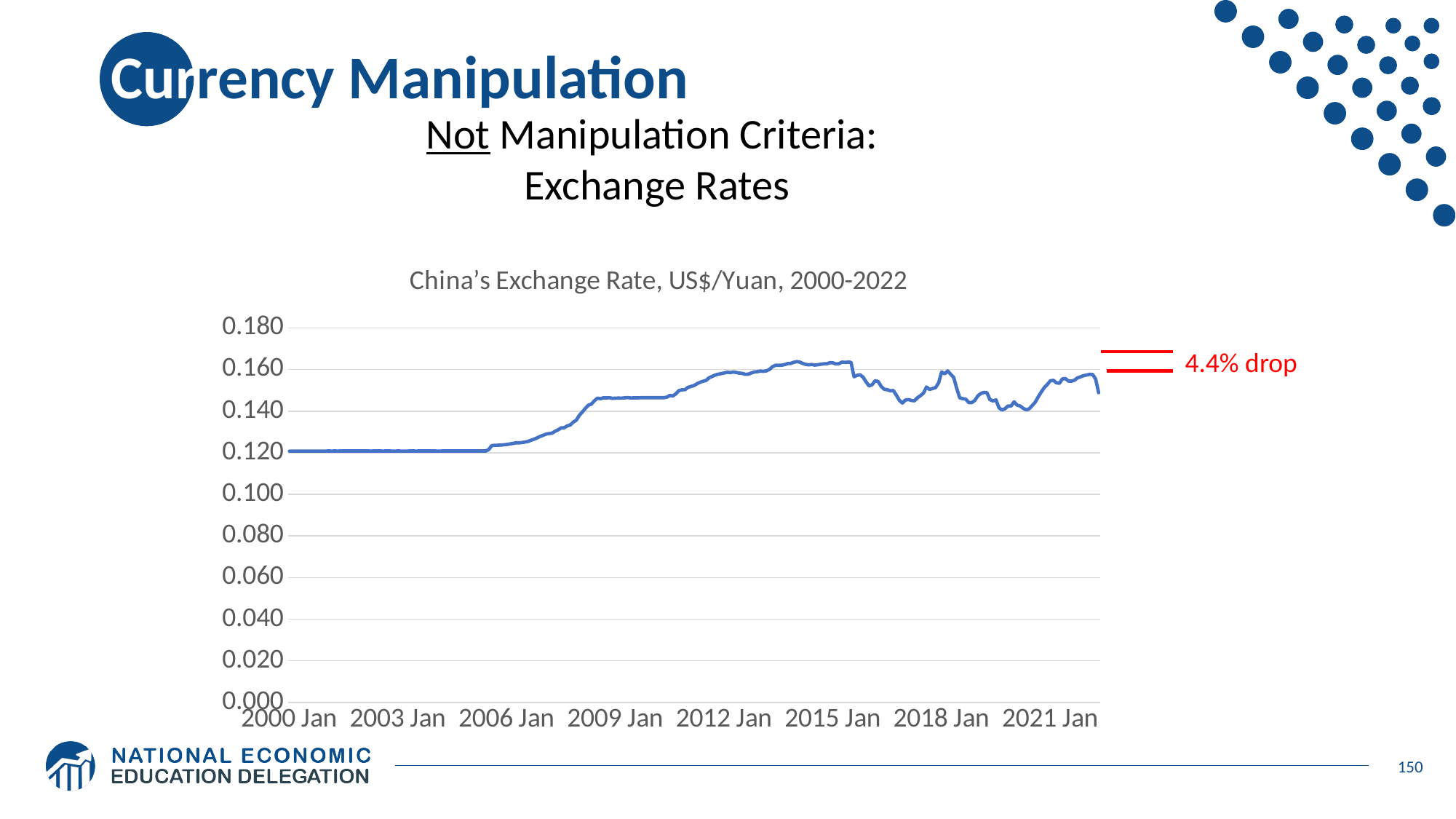
What type of chart is shown on the slide? line chart Is the value in 2021 Jan greater or less than 0.160? less Is the value in 2015 Jan greater or less than 0.160? greater Does the exchange rate rise or fall overall between 2015 Jan and 2021 Jan? fall Is the value in 2000 Jan greater or less than 0.140? less Which is higher, the value in 2012 Jan or the value in 2006 Jan? 2012 Jan Does the exchange rate rise or fall between 2006 Jan and 2012 Jan? rise What percentage drop is annotated in red at the right end of the line? 4.4% drop What is the title of the chart? China's Exchange Rate, US$/Yuan, 2000-2022 How many year labels are shown on the x axis? 8